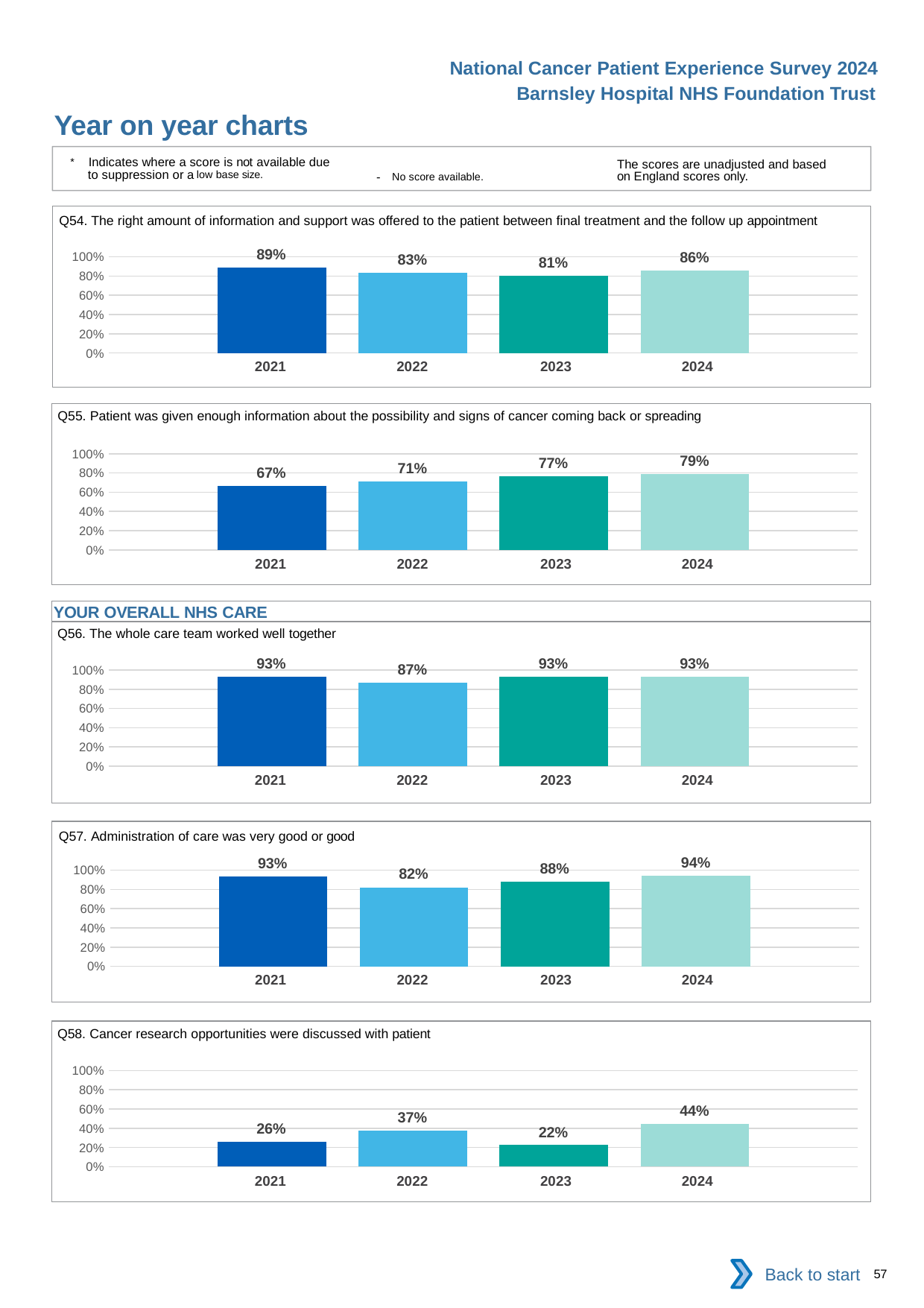
In the Q54 chart, which year has the lowest value? 2023 In the Q56 chart, which year has the lowest value? 2022 In the Q57 chart, what is the difference between the 2021 and 2022 values? 11% In the Q54 chart, what is the value for 2021? 89% In the Q55 chart, do the values rise or fall from 2021 to 2024? rise In the Q56 chart, how many years are shown on the x axis? 4 In the Q55 chart, what is the difference between the 2024 and 2021 values? 12% In the Q57 chart, which year has the highest value? 2024 What type of chart is the Q58 chart? bar chart In the Q55 chart, what is the value for 2024? 79% In the Q58 chart, what is the value for 2023? 22% In the Q58 chart, is the value for 2022 larger or smaller than the value for 2021? larger